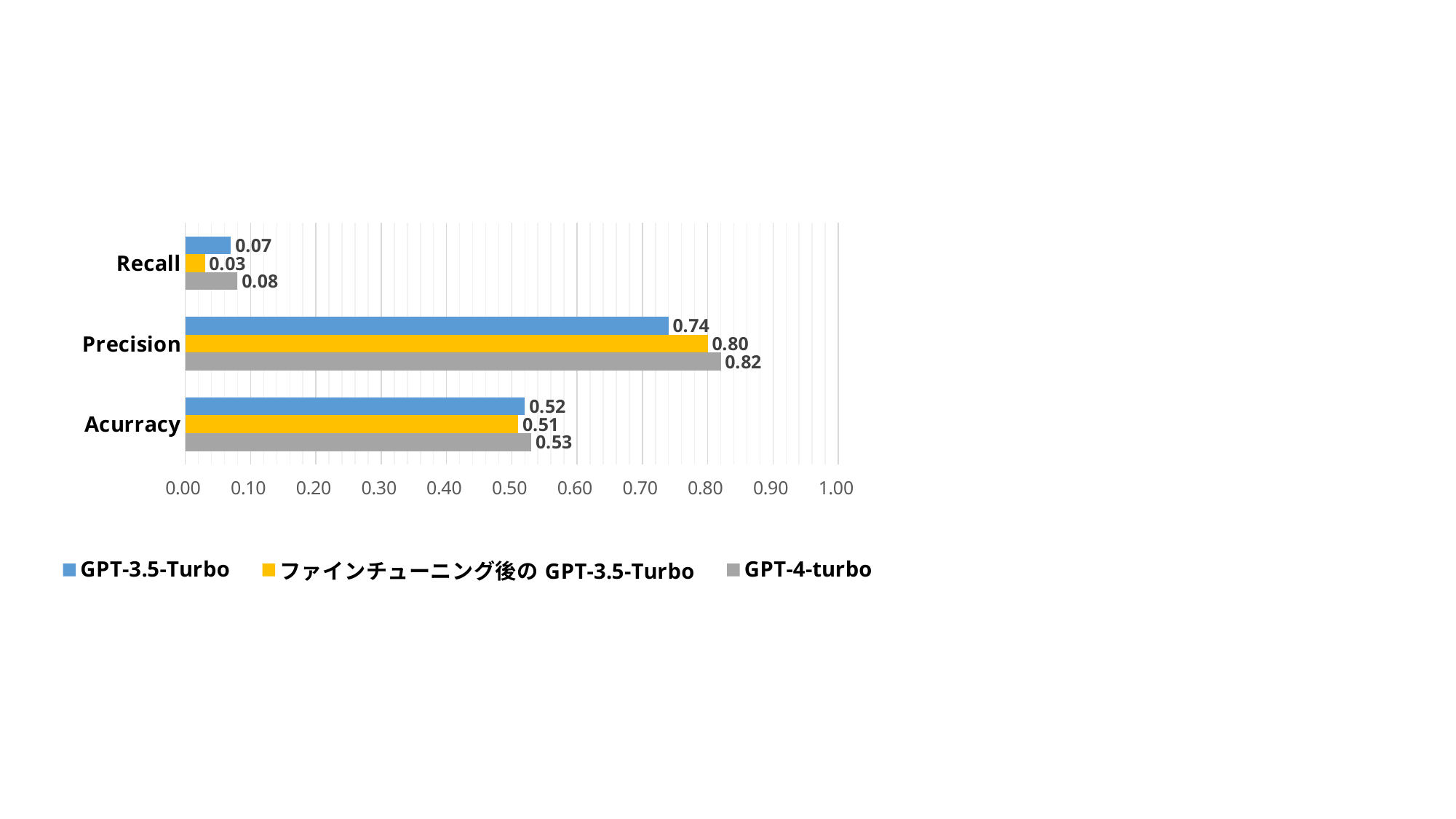
What kind of chart is shown on the slide? Bar chart What colour represents GPT-4-turbo in the chart? Gray Is the Precision value for GPT-3.5-Turbo greater or less than 0.70? greater How many series does the legend list? 3 What is the Precision value for GPT-4-turbo? 0.82 What is the Recall value for ファインチューニング後の GPT-3.5-Turbo? 0.03 What is the Acurracy value for GPT-3.5-Turbo? 0.52 Which series has the highest Precision value? GPT-4-turbo How many categories are shown on the chart? 3 Which is larger: the Precision value for ファインチューニング後の GPT-3.5-Turbo or for GPT-3.5-Turbo? ファインチューニング後の GPT-3.5-Turbo What is the difference between the Precision values of GPT-4-turbo and GPT-3.5-Turbo? 0.08 Which series has the lowest Recall value? ファインチューニング後の GPT-3.5-Turbo